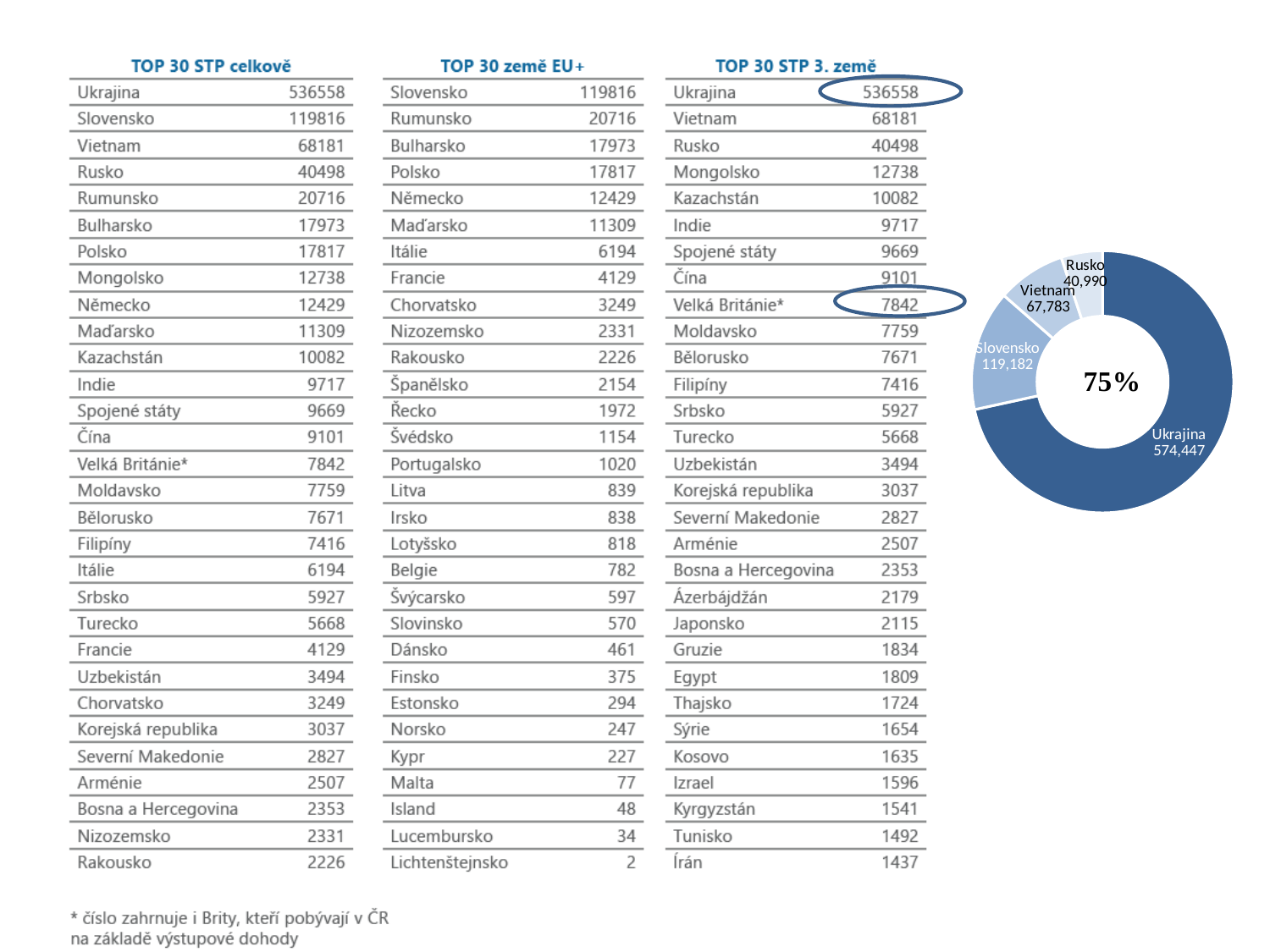
In the doughnut chart on the right, what value is shown for Slovensko? 119,182 How many slices does the doughnut chart on the right have? 4 In the doughnut chart on the right, which country has the smallest slice? Rusko In the doughnut chart on the right, what is the difference between the values for Ukrajina and Slovensko? 455,265 In the doughnut chart on the right, what value is shown for Ukrajina? 574,447 In the doughnut chart on the right, what value is shown for Vietnam? 67,783 In the doughnut chart on the right, which country has the largest slice? Ukrajina In the doughnut chart on the right, what is the difference between the values for Vietnam and Rusko? 26,793 In the doughnut chart on the right, which is larger, the value for Slovensko or the value for Vietnam? Slovensko In the doughnut chart on the right, what value is shown for Rusko? 40,990 What kind of chart is shown on the right side of the slide? Doughnut (pie) chart What percentage is printed in the centre of the doughnut chart on the right? 75%